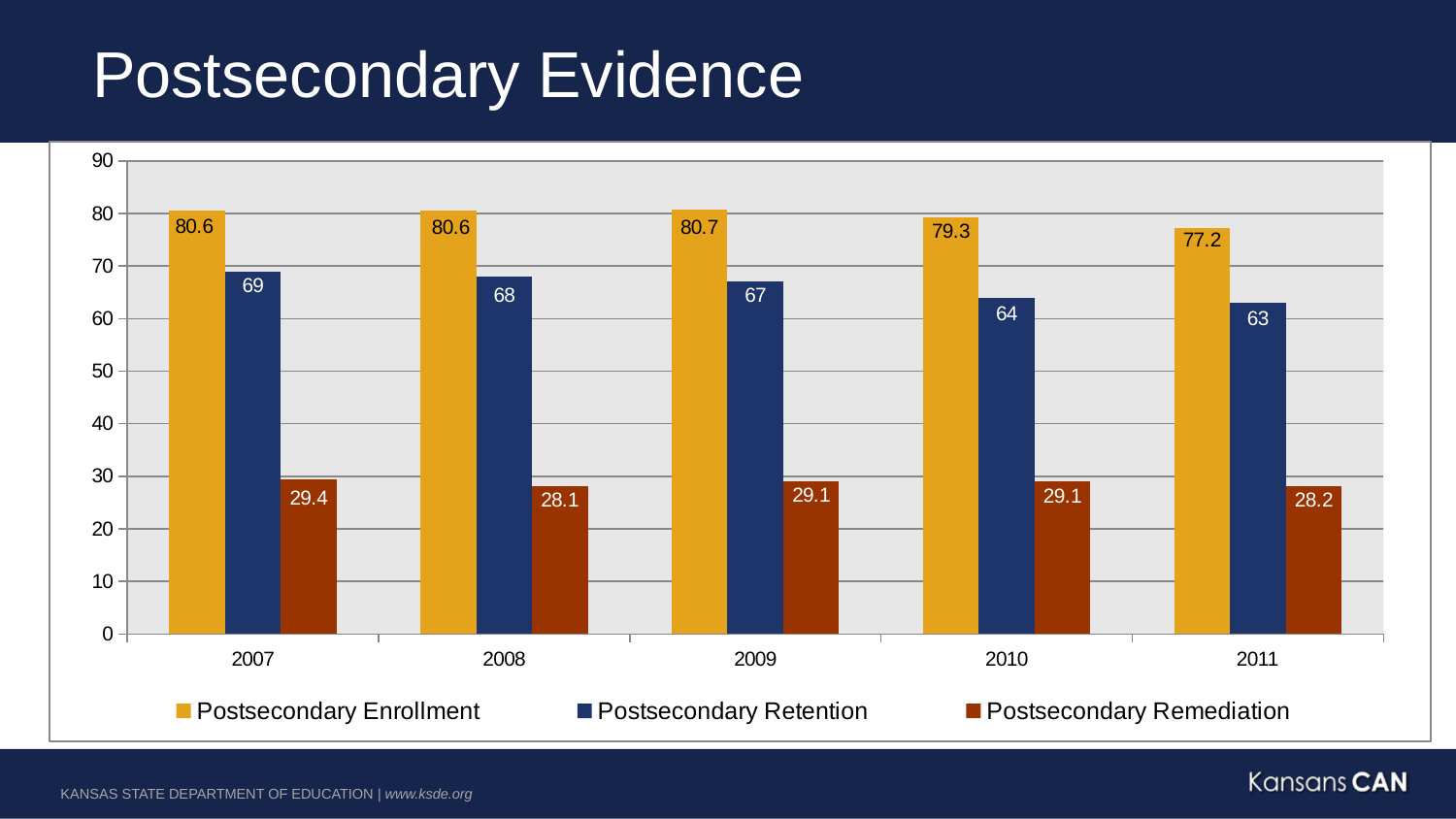
What is the Postsecondary Enrollment value for 2009? 80.7 How many years are shown on the x axis? 5 Which is larger, Postsecondary Remediation in 2007 or in 2011? 2007 What is the title of the slide? Postsecondary Evidence What is the Postsecondary Retention value for 2010? 64 What is the difference between Postsecondary Enrollment and Postsecondary Retention in 2011? 14.2 What kind of chart is shown on the slide? Bar chart Does Postsecondary Retention rise or fall from 2007 to 2011? Fall Which year has the highest Postsecondary Retention value? 2007 How many series does the legend list? 3 Which year has the lowest Postsecondary Enrollment value? 2011 What is the Postsecondary Remediation value for 2008? 28.1